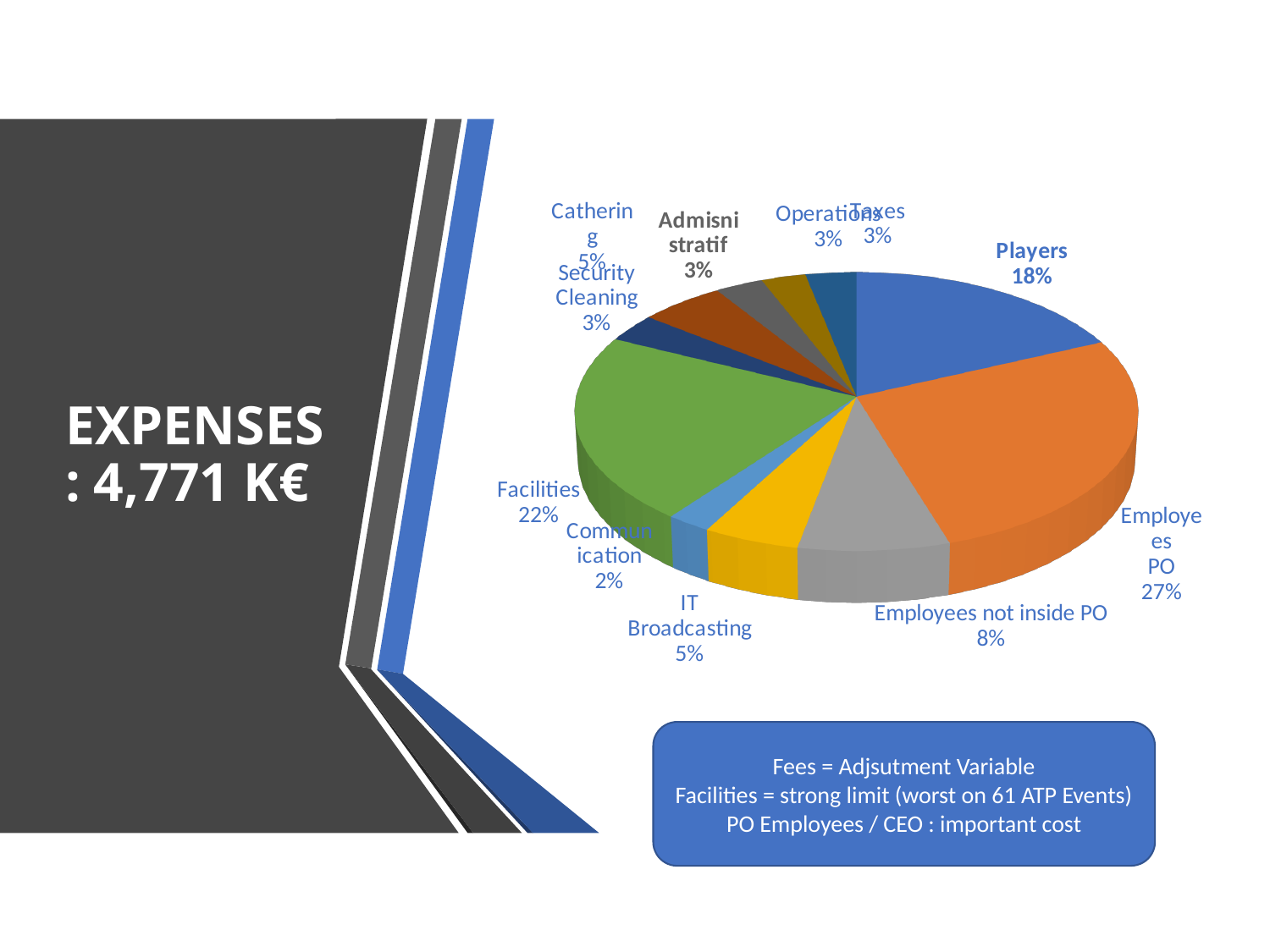
What share of expenses goes to Players? 18% What percentage is shown for Security Cleaning? 3% What percentage is shown for Employees not inside PO? 8% Which category has the largest share of expenses? Employees PO What percentage is shown for Facilities? 22% What percentage is shown for IT Broadcasting? 5% What percentage is shown for Employees PO? 27% What total expenses amount is stated in the slide title? 4,771 K€ Which is larger, Facilities or Players? Facilities How many percentage points larger is Employees PO than Players? 9 Which category has the smallest share of expenses? Communication What kind of chart is shown on the slide? pie chart